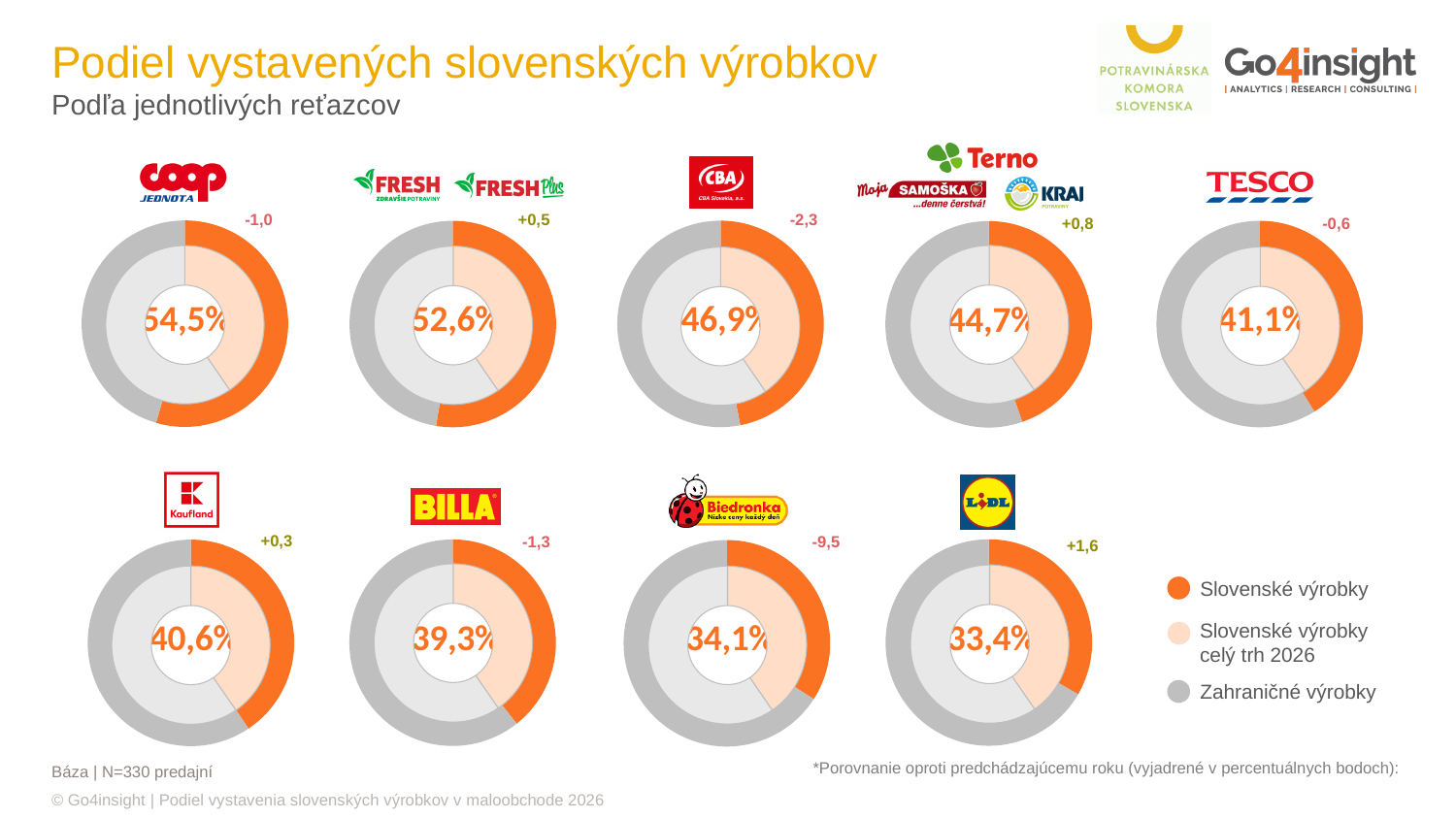
How many entries does the legend list? 3 What share of Slovak products is shown for Lidl? 33,4% What is the difference between the share of Slovak products at COOP Jednota and at Lidl? 21,1 percentage points What type of chart is used to show the share of Slovak products for each chain? Donut chart What year-on-year change (in percentage points) is shown for Biedronka? -9,5 What share of Slovak products is shown for Tesco? 41,1% What share of Slovak products is shown for COOP Jednota? 54,5% Which retail chain has the lowest share of Slovak products? Lidl Which retail chain has the highest share of Slovak products? COOP Jednota Which has a higher share of Slovak products, Billa or Kaufland? Kaufland How many retail chains have a donut chart on the slide? 9 What year-on-year change (in percentage points) is shown for Lidl? +1,6